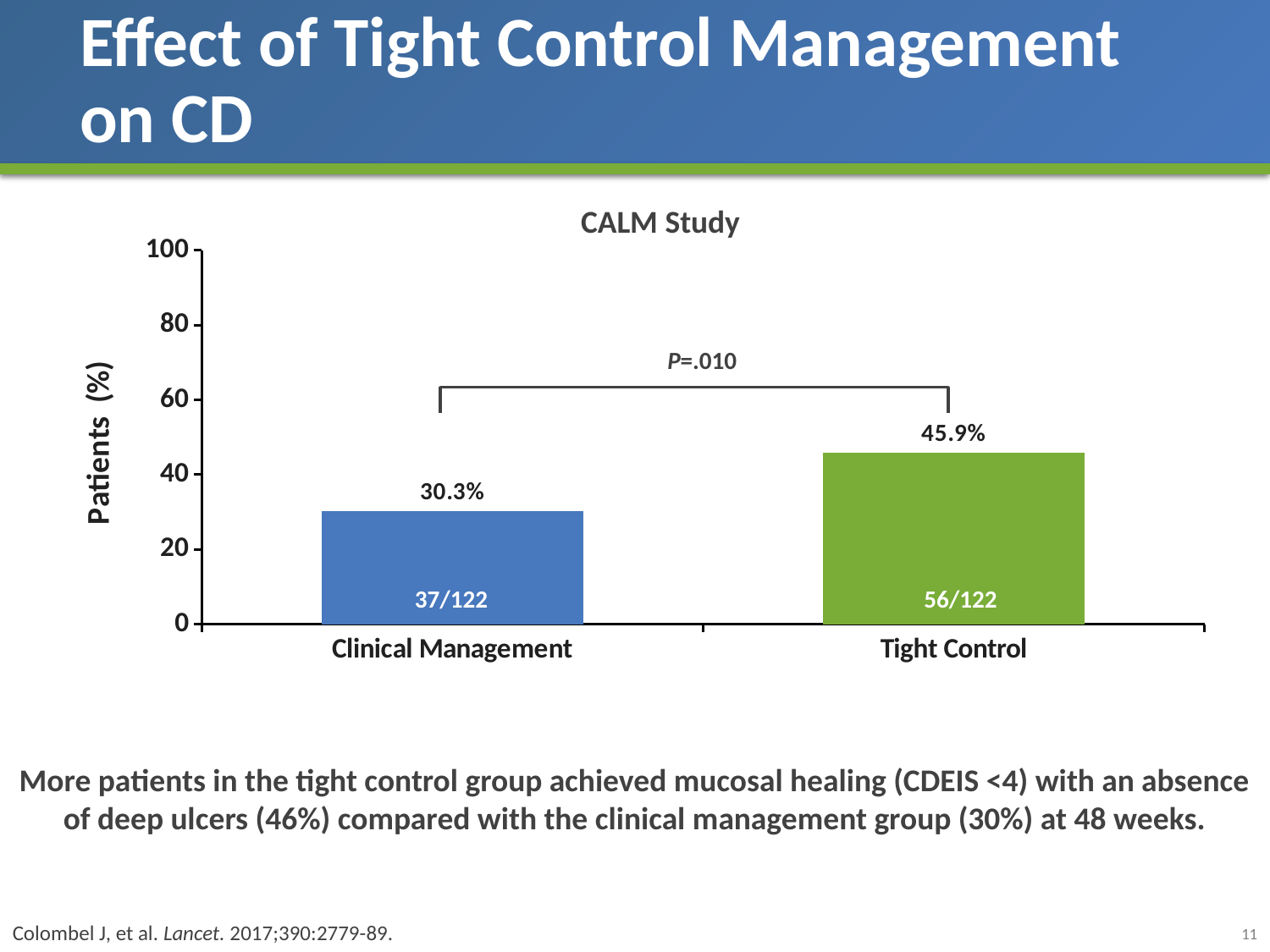
What is the value for Clinical Management? 30.3% How many patients out of 122 are shown inside the Tight Control bar? 56/122 Is the value for Tight Control greater or less than 40? greater How many categories are shown on the x axis? 2 What kind of chart is shown? bar chart What is the value for Tight Control? 45.9% What is the title of the chart? CALM Study What is the y-axis label of the chart? Patients (%) Which category has the lowest value? Clinical Management Which is larger, the value for Clinical Management or the value for Tight Control? Tight Control What is the difference between the Tight Control and Clinical Management values? 15.6% Which category has the highest value? Tight Control